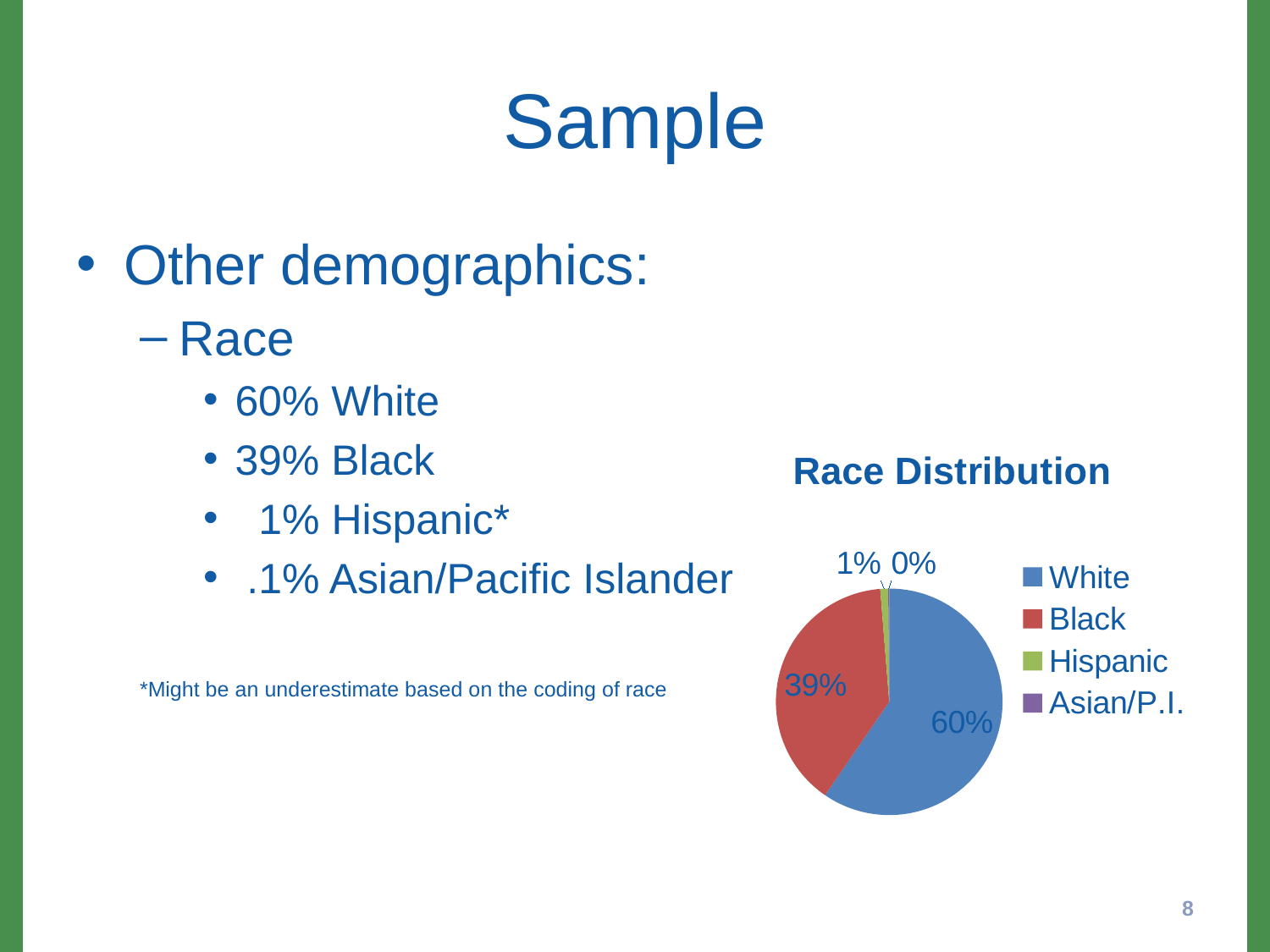
What is the difference in percentage points between the White and Black slices? 21 What percentage of the pie does the Black slice represent? 39% What percentage is shown for the Hispanic slice? 1% Which category has the smallest share of the pie? Asian/P.I. What is the title of the chart? Race Distribution What percentage of the pie does the White slice represent? 60% How many categories does the legend list? 4 Which category has the largest share of the pie? White What colour is the Black slice in the pie chart? red What type of chart is shown on the slide? pie chart Which slice is larger, Black or Hispanic? Black What percentage label is shown for the Asian/P.I. slice? 0%